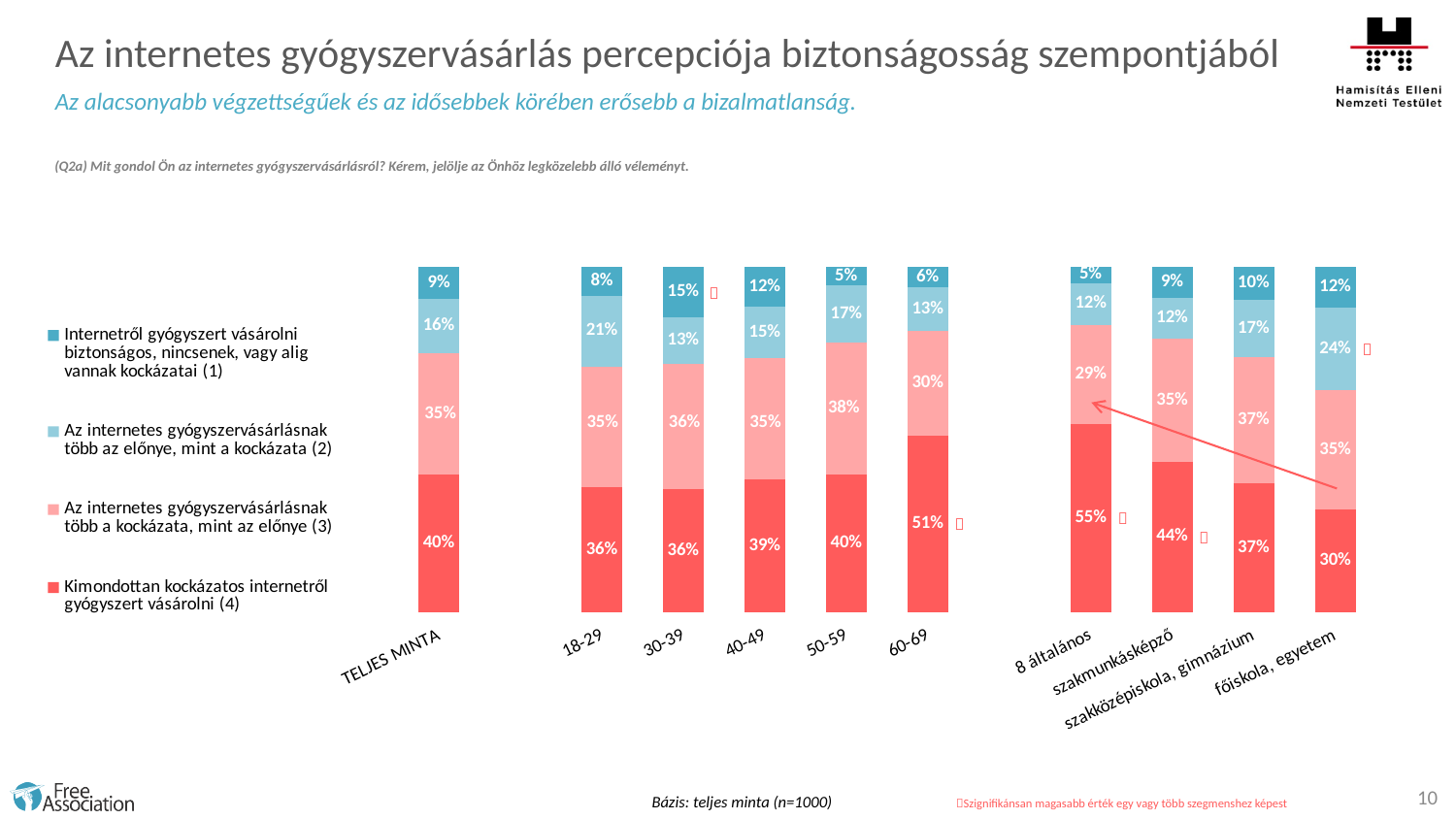
Which age group (18-29 to 60-69) has the lowest value for the 'biztonságos, nincsenek, vagy alig vannak kockázatai (1)' series? 50-59 How many series does the legend list? 4 Which category has the highest value for the 'Kimondottan kockázatos internetről gyógyszert vásárolni (4)' series? 8 általános What share of the 'főiskola, egyetem' group falls into the 'több az előnye, mint a kockázata (2)' category? 24% What kind of chart is shown on the slide? Stacked bar chart What percentage of the 60-69 age group says it is outright risky to buy medicine online (series 4, 'Kimondottan kockázatos')? 51% How many bars (categories) are plotted on the slide in total? 10 What is the difference between the 'Kimondottan kockázatos (4)' values for 8 általános and főiskola, egyetem? 25% What colour represents the 'Kimondottan kockázatos internetről gyógyszert vásárolni (4)' series? Red What is the value of the 'Kimondottan kockázatos internetről gyógyszert vásárolni (4)' series for the TELJES MINTA bar? 40% Across the education categories from 8 általános to főiskola, egyetem, does the 'Kimondottan kockázatos (4)' value rise or fall? Fall Which is larger: the 'Kimondottan kockázatos (4)' value for 60-69 or for 18-29? 60-69